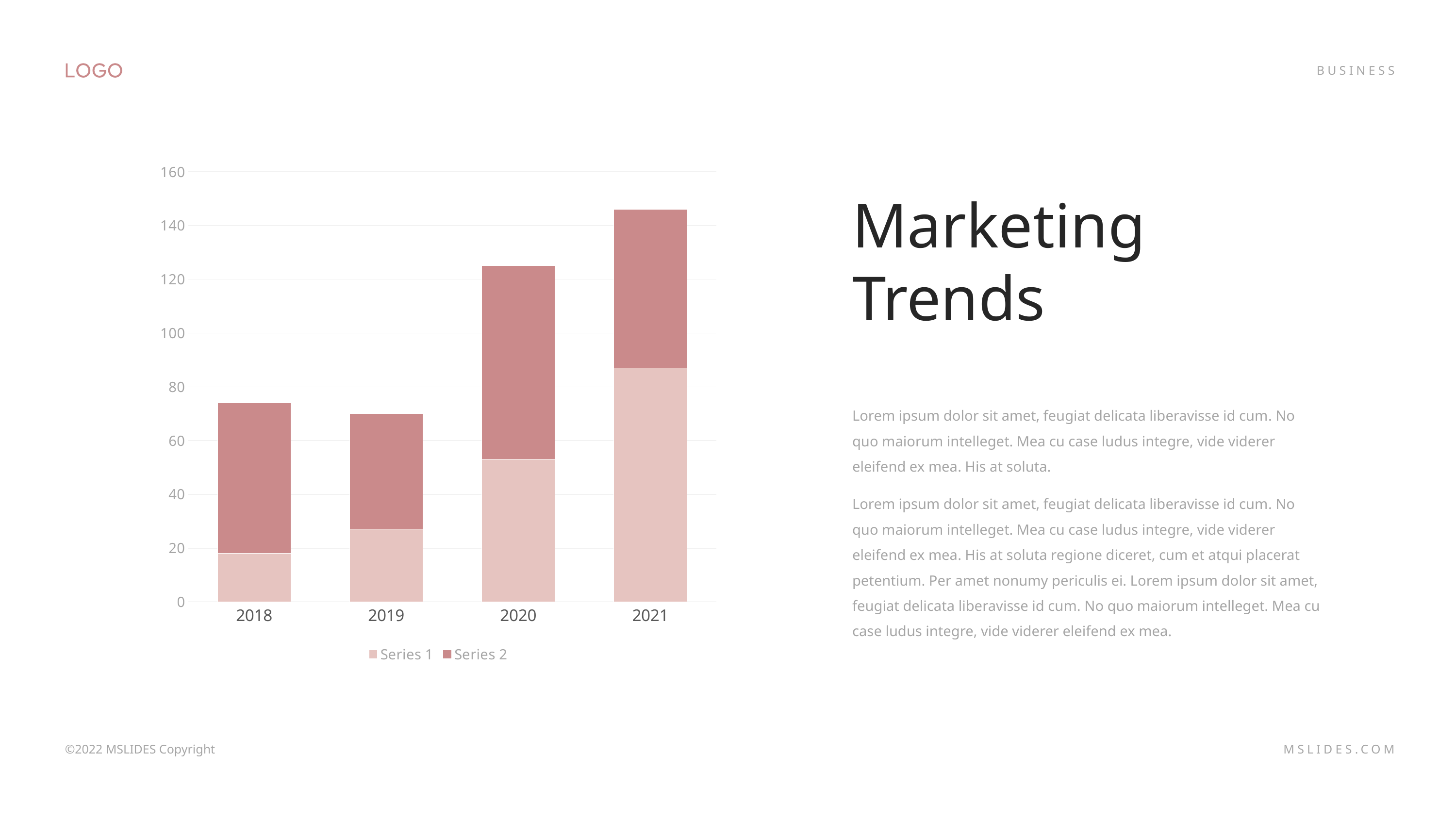
What kind of chart is shown on the slide? Stacked bar chart Does the Series 1 value rise or fall from 2018 to 2021? rise Is the total stacked value for 2018 greater or less than 80? less Is the total stacked value for 2021 greater or less than 140? greater Which year has the larger total stacked value, 2019 or 2020? 2020 Is the total stacked value for 2020 greater or less than 120? greater How many years are shown on the x axis of the chart? 4 Which year has the smallest Series 1 value? 2018 Which year has the largest Series 1 value? 2021 Which year has the tallest stacked bar in the chart? 2021 How many series does the chart legend list? 2